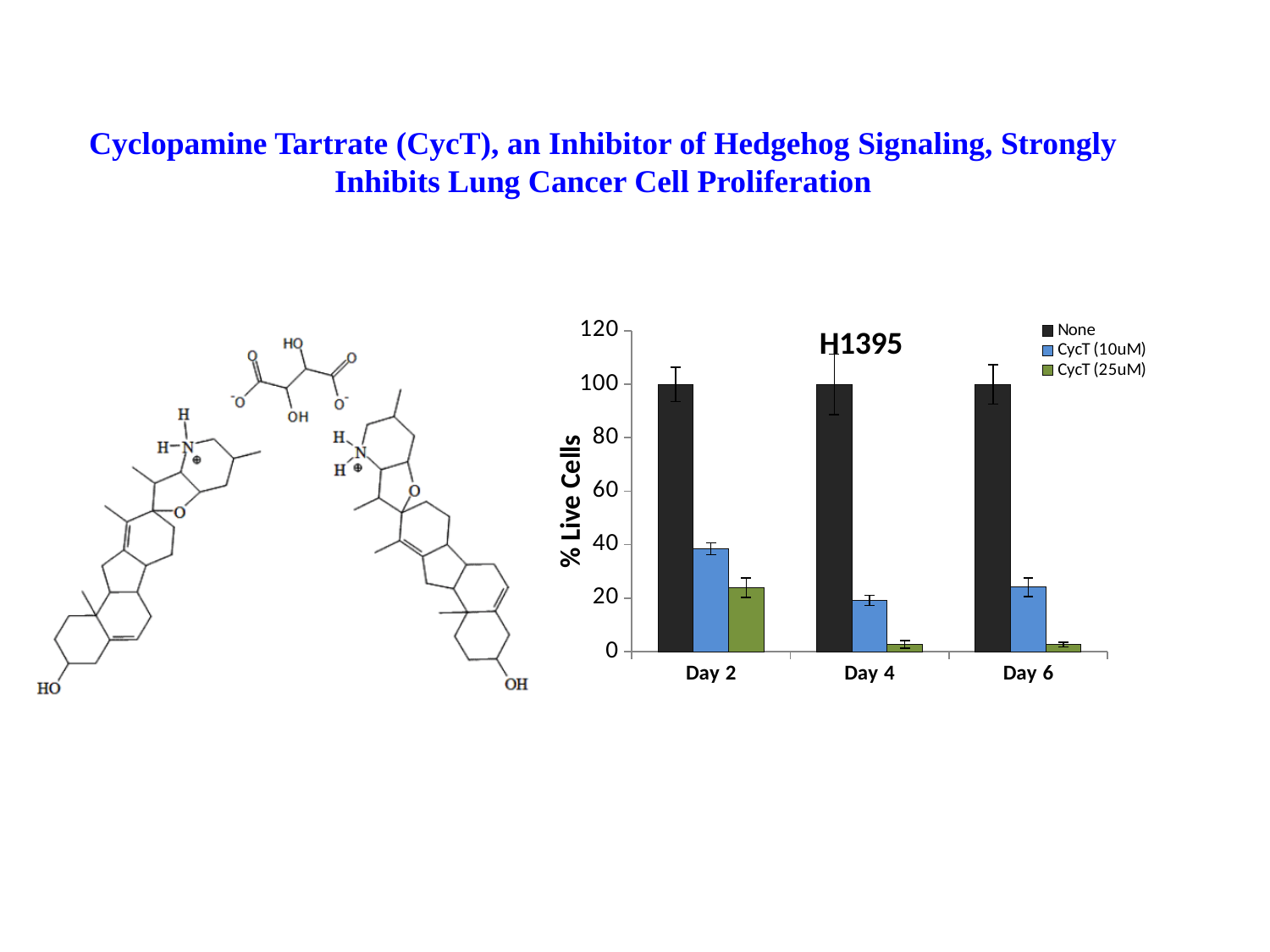
Which is larger, the CycT (10uM) value at Day 2 or at Day 4? Day 2 Which series has the highest value at Day 2? None Which series has the lowest value at Day 6? CycT (25uM) What is the label of the y axis of the chart? % Live Cells What kind of chart is shown on the slide? bar chart Is the value for CycT (10uM) at Day 2 greater or less than 20? greater Do the values for CycT (25uM) rise or fall from Day 2 to Day 6? fall How many categories are shown on the x axis? 3 How many series does the legend list? 3 Is the value for CycT (25uM) at Day 4 greater or less than 20? less What is the value for the None series at Day 4? 100 What is the title of the chart? H1395